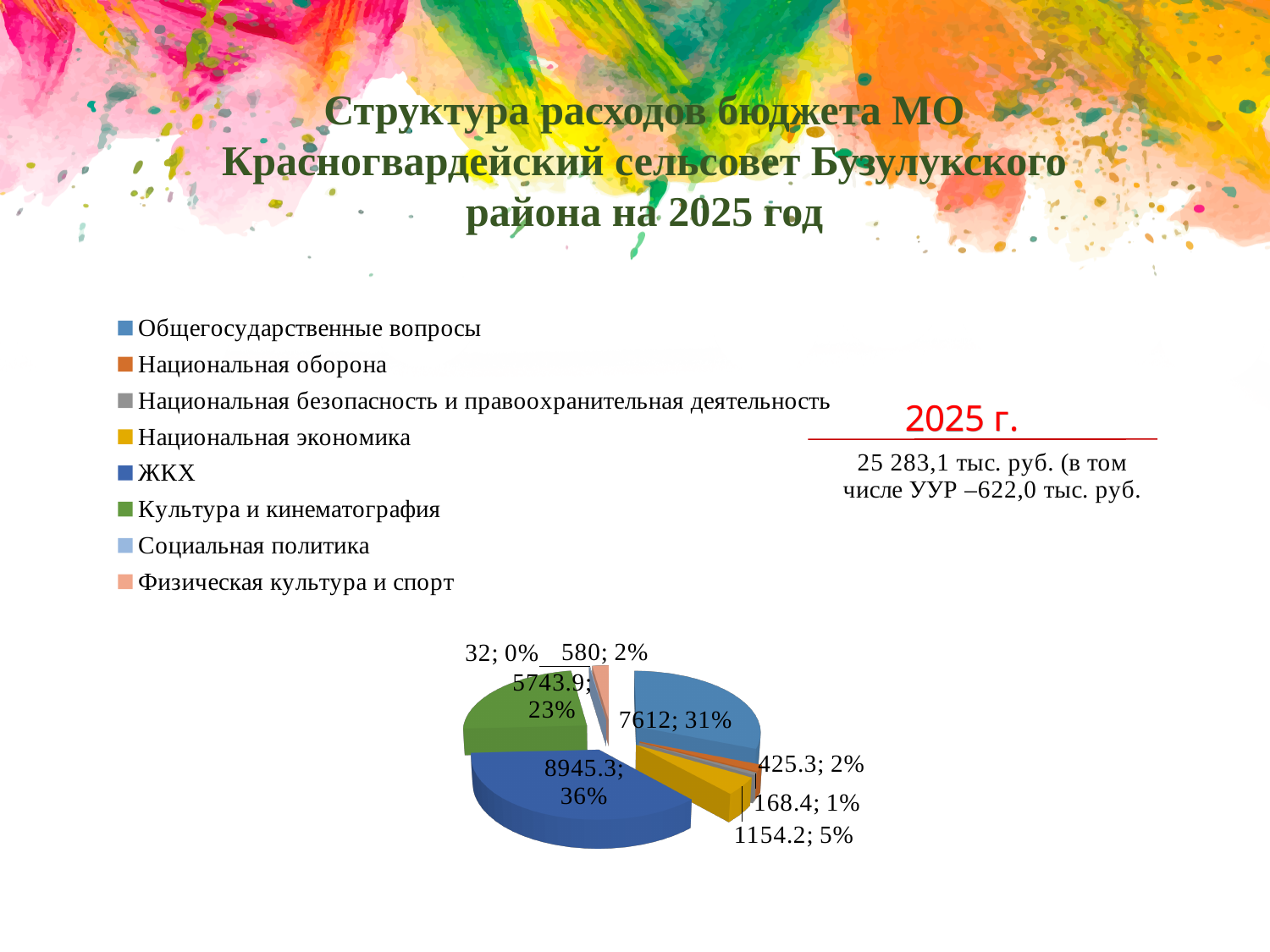
What value is shown for the Национальная экономика slice? 1154.2 What year is stated in the red heading next to the legend? 2025 г. What percentage share does the Общегосударственные вопросы slice have? 31% Which category has the largest slice in the pie chart? ЖКХ Which is larger: the value for Национальная оборона or the value for Физическая культура и спорт? Физическая культура и спорт What percentage share does the ЖКХ slice have in the pie chart? 36% How many categories does the legend of the pie chart list? 8 Which category has the smallest slice in the pie chart? Социальная политика What value is shown for the Культура и кинематография slice? 5743.9 What is the difference between the ЖКХ value and the Общегосударственные вопросы value? 1333.3 What type of chart is shown on the slide? pie chart What value is shown for the ЖКХ slice of the pie chart? 8945.3